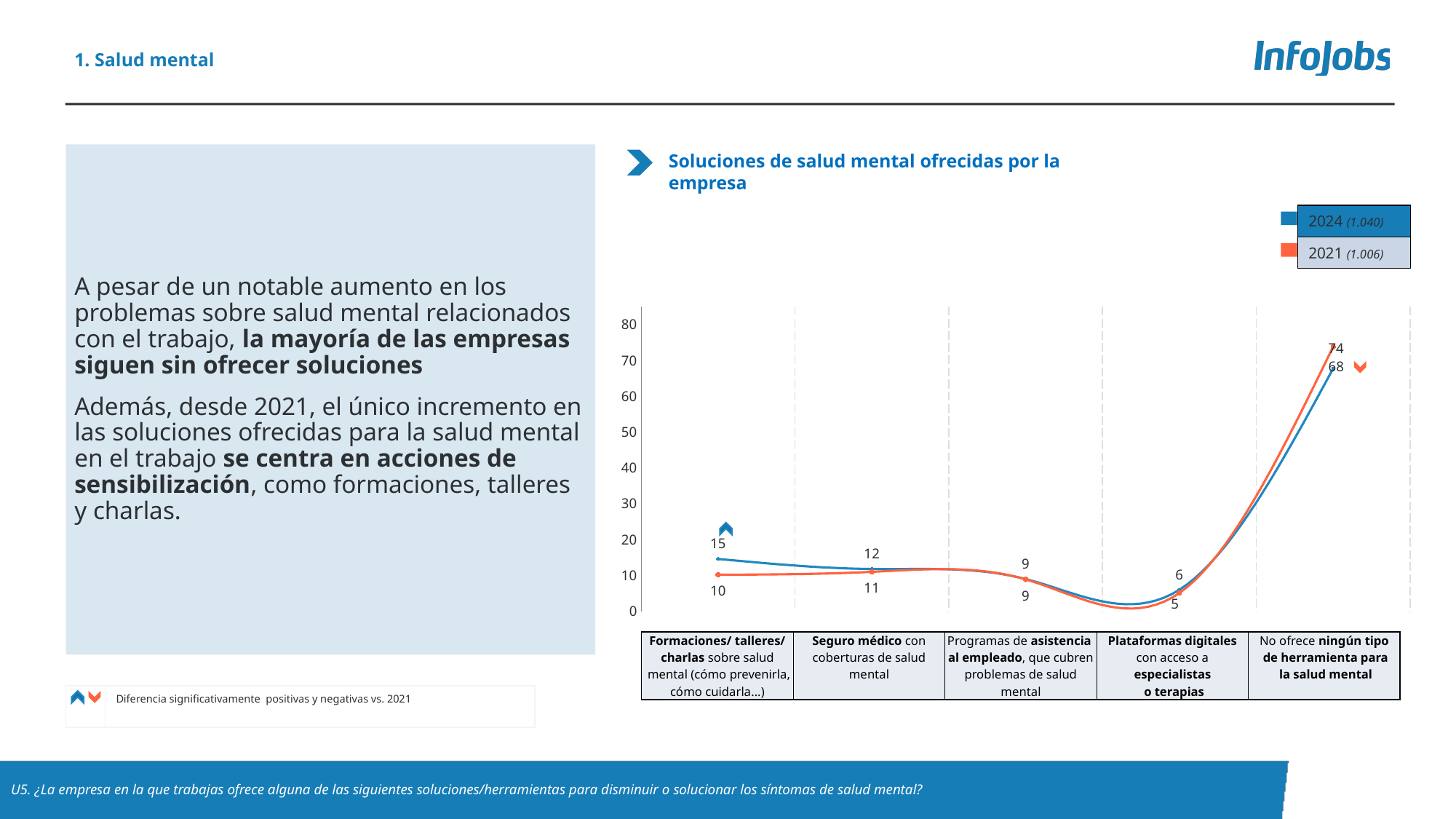
What is the difference between the 2021 and 2024 values for 'No ofrece ningún tipo de herramienta para la salud mental'? 6 How many categories are shown on the x axis of the chart? 5 What kind of chart is shown on the slide? line chart What is the 2021 value for 'Plataformas digitales con acceso a especialistas o terapias'? 5 What is the 2021 value for 'Seguro médico con coberturas de salud mental'? 11 What is the 2024 value for 'Formaciones/ talleres/ charlas sobre salud mental'? 15 How many series does the legend list? 2 For 'Formaciones/ talleres/ charlas sobre salud mental', which year has the larger value, 2024 or 2021? 2024 What is the title of the chart? Soluciones de salud mental ofrecidas por la empresa Which category has the lowest 2021 value? Plataformas digitales con acceso a especialistas o terapias What is the 2024 value for 'No ofrece ningún tipo de herramienta para la salud mental'? 68 Which category has the highest 2024 value? No ofrece ningún tipo de herramienta para la salud mental